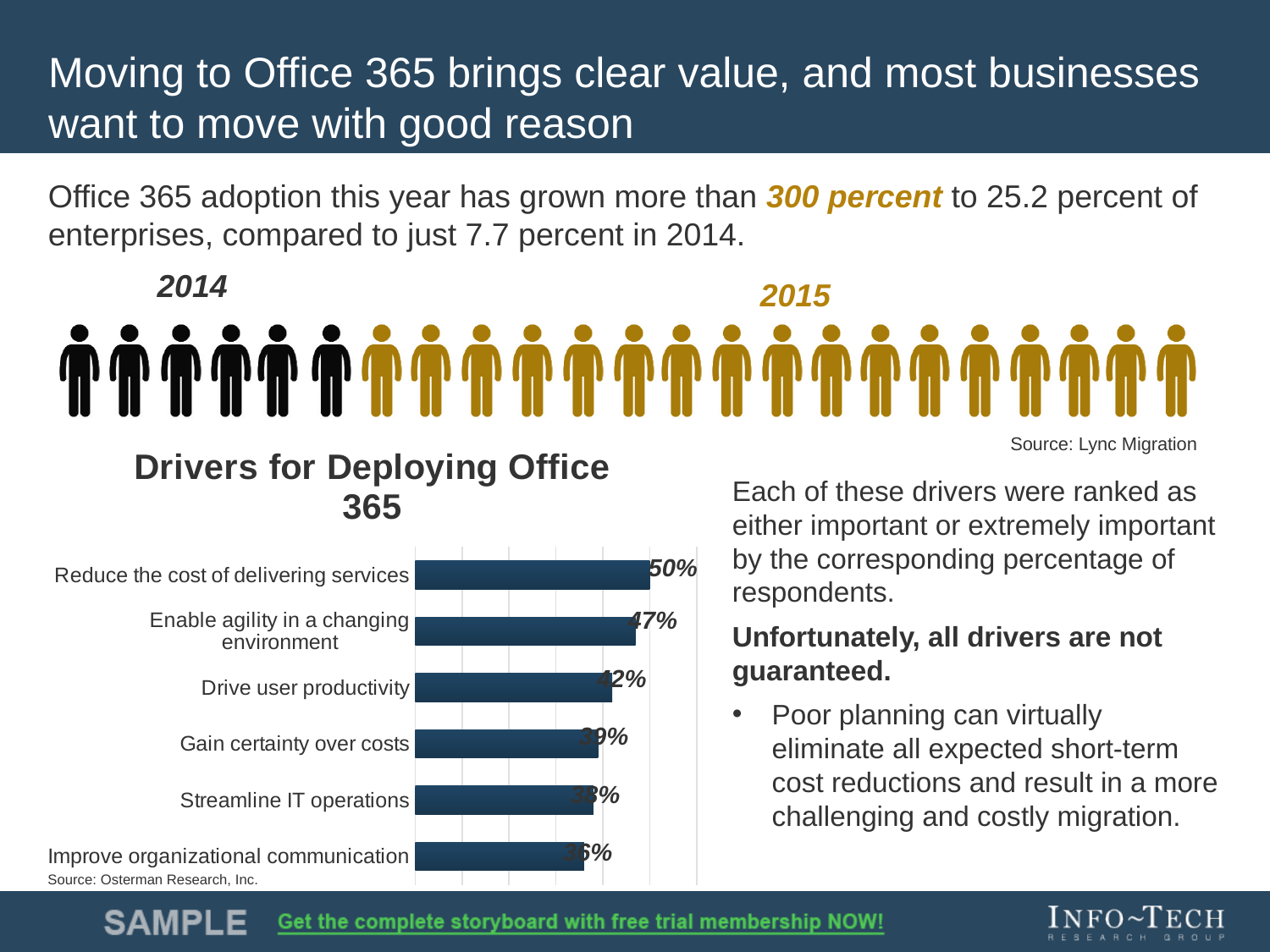
In the 'Drivers for Deploying Office 365' chart, which is larger: 'Gain certainty over costs' or 'Improve organizational communication'? Gain certainty over costs What is the title of the bar chart on the slide? Drivers for Deploying Office 365 What kind of chart is 'Drivers for Deploying Office 365'? bar chart What source is cited below the 'Drivers for Deploying Office 365' chart? Osterman Research, Inc. Which driver has the highest percentage in the 'Drivers for Deploying Office 365' chart? Reduce the cost of delivering services In the 'Drivers for Deploying Office 365' chart, what percentage is shown for 'Reduce the cost of delivering services'? 50% Which driver has the lowest percentage in the 'Drivers for Deploying Office 365' chart? Improve organizational communication In the 'Drivers for Deploying Office 365' chart, what is the difference between 'Reduce the cost of delivering services' and 'Enable agility in a changing environment'? 3% In the 'Drivers for Deploying Office 365' chart, what percentage is shown for 'Enable agility in a changing environment'? 47% In the 'Drivers for Deploying Office 365' chart, do the bar values increase or decrease from the top category to the bottom category? decrease In the 'Drivers for Deploying Office 365' chart, which is larger: 'Drive user productivity' or 'Streamline IT operations'? Drive user productivity How many drivers are listed in the 'Drivers for Deploying Office 365' chart? 6